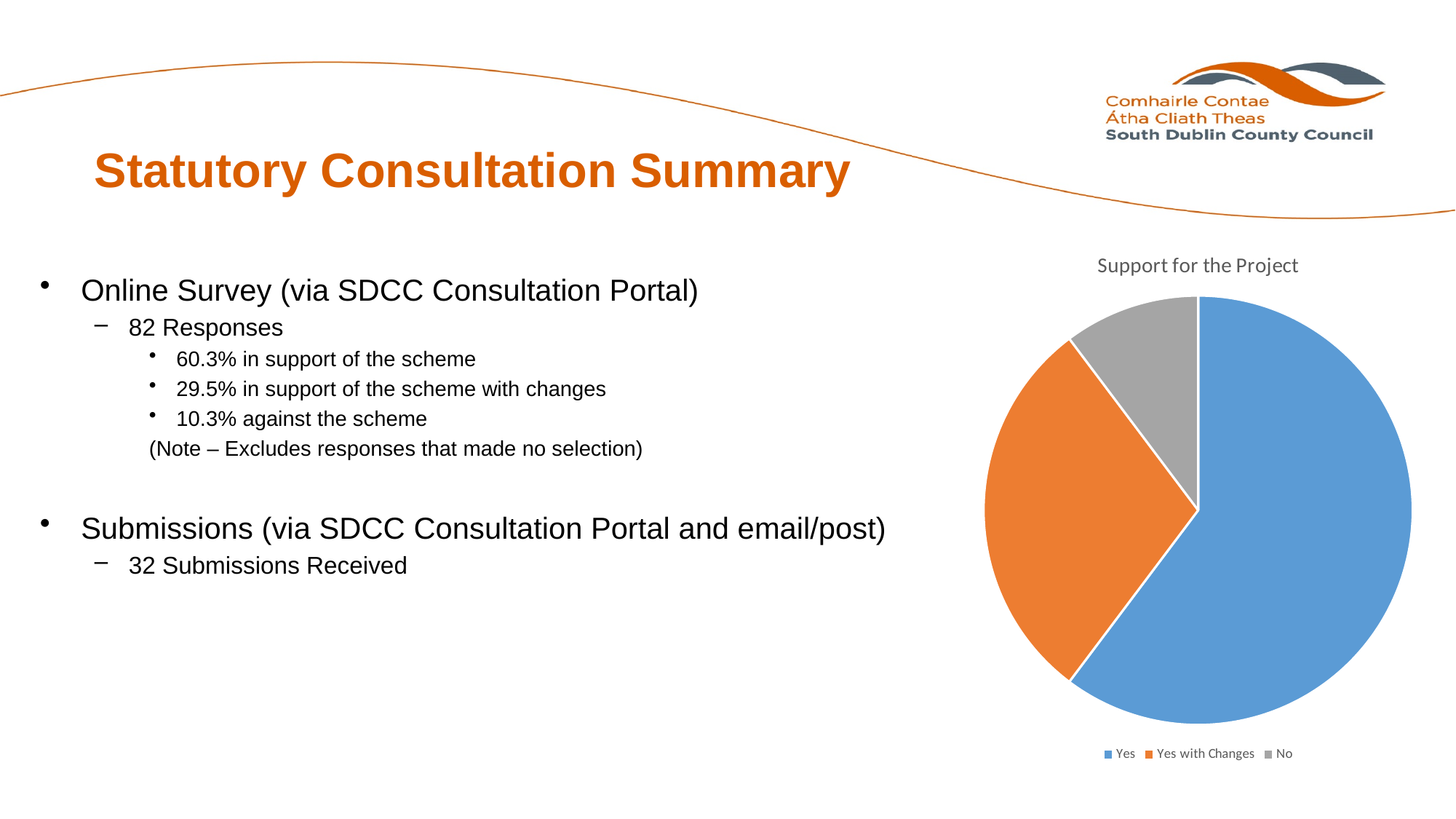
According to the slide, what share of responses were in support of the scheme (the Yes slice)? 60.3% What is the title of the chart? Support for the Project Which category has the smallest slice of the pie? No How many entries does the chart legend list? 3 According to the slide, what share of responses were against the scheme (the No slice)? 10.3% Which slice is larger, Yes with Changes or No? Yes with Changes Which category has the largest slice of the pie? Yes Which slice is larger, Yes or Yes with Changes? Yes How many slices does the pie chart have? 3 What kind of chart is shown on the slide? pie chart What colour is the Yes with Changes slice? orange According to the slide, what share of responses were in support of the scheme with changes (the Yes with Changes slice)? 29.5%